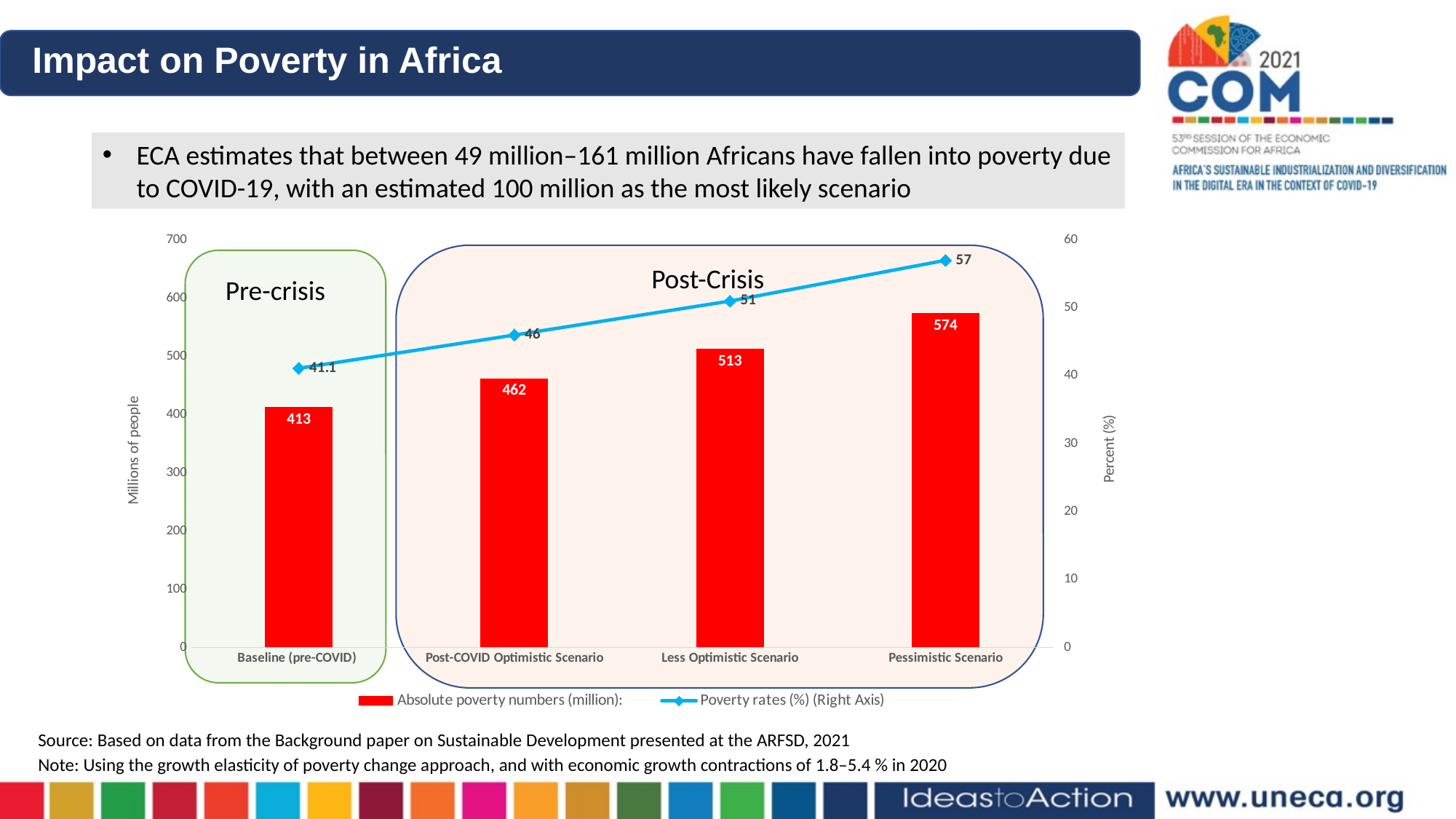
Which scenario has the highest absolute poverty number? Pessimistic Scenario How many series does the chart legend list? 2 What is the absolute poverty number (million) for the Baseline (pre-COVID) scenario? 413 Which has a higher absolute poverty number: the Post-COVID Optimistic Scenario or the Less Optimistic Scenario? Less Optimistic Scenario Do the poverty rates rise or fall from the Baseline (pre-COVID) to the Pessimistic Scenario? rise What is the difference in absolute poverty numbers (million) between the Pessimistic Scenario and the Baseline (pre-COVID)? 161 What is the poverty rate (%) for the Baseline (pre-COVID) scenario? 41.1 What is the poverty rate (%) for the Pessimistic Scenario? 57 What is the absolute poverty number (million) for the Less Optimistic Scenario? 513 Which scenario has the lowest poverty rate? Baseline (pre-COVID) What is the label of the left vertical axis of the chart? Millions of people How many scenarios are shown on the x axis of the chart? 4